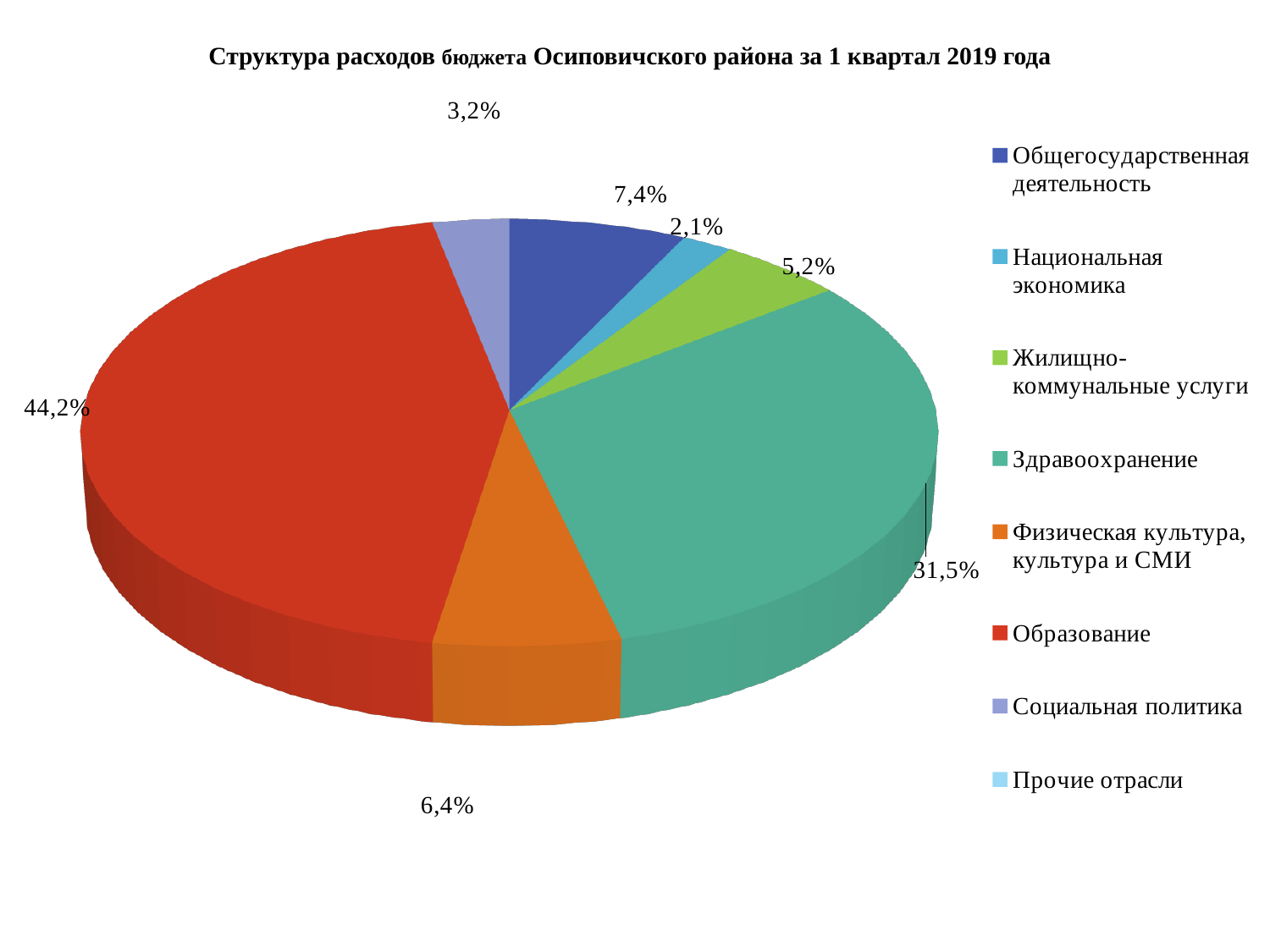
What is the difference in percentage points between Образование and Здравоохранение? 12,7 Which labelled category has the smallest share of expenditure? Национальная экономика How many categories does the legend list? 8 What share of expenditure goes to Социальная политика? 3,2% What share of expenditure goes to Общегосударственная деятельность? 7,4% What kind of chart is shown on the slide? pie chart What share of expenditure goes to Физическая культура, культура и СМИ? 6,4% What share of expenditure goes to Образование? 44,2% Which has a larger share: Общегосударственная деятельность or Физическая культура, культура и СМИ? Общегосударственная деятельность What share of expenditure goes to Жилищно-коммунальные услуги? 5,2% Which category has the largest share of expenditure? Образование What share of expenditure goes to Здравоохранение? 31,5%